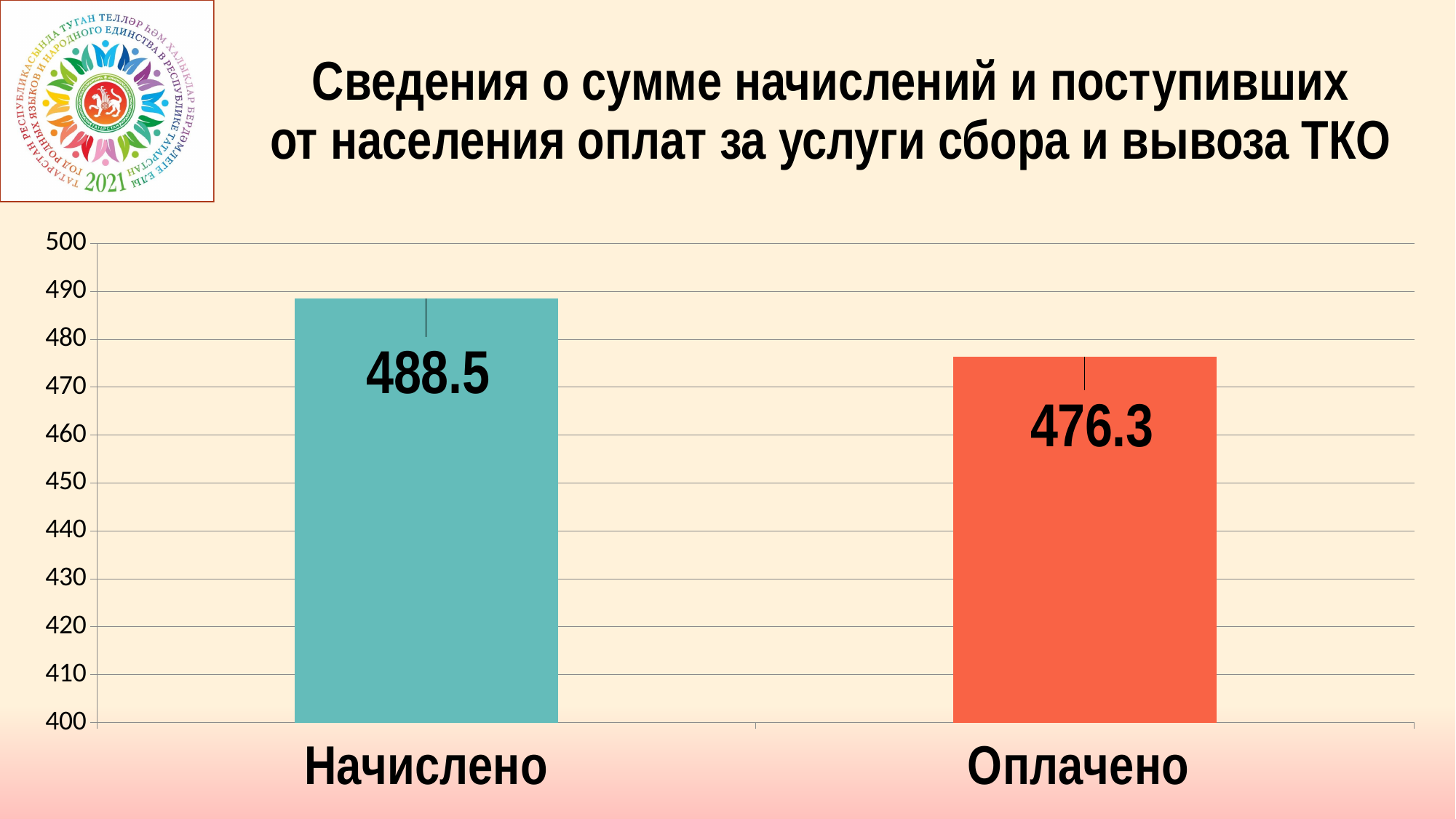
What is the difference between the values for Начислено and Оплачено? 12.2 Is the value for Начислено greater or less than 480? greater What kind of chart is shown on the slide? bar chart Which category has the highest value? Начислено What is the value for Оплачено? 476.3 Which category has the lowest value? Оплачено What colour is the bar for Оплачено? orange-red How many categories are shown on the chart? 2 What is the lowest value shown on the vertical axis? 400 What is the value for Начислено? 488.5 Is the value for Оплачено greater or less than 480? less Which is larger, the value for Начислено or the value for Оплачено? Начислено